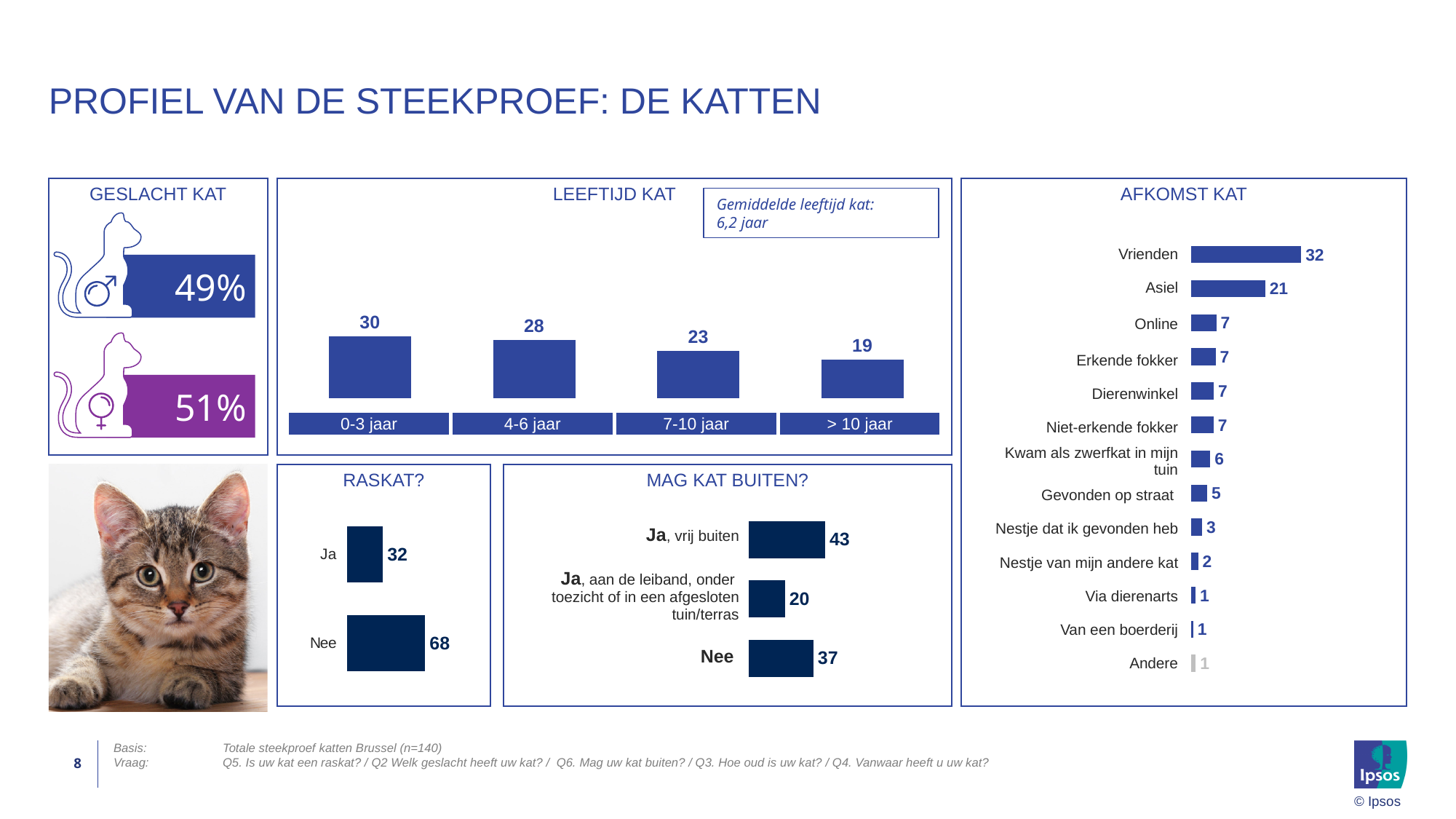
What type of chart is the AFKOMST KAT chart? bar chart In the AFKOMST KAT chart, what is the value for Asiel? 21 In the MAG KAT BUITEN? chart, what is the value for 'Ja, aan de leiband, onder toezicht of in een afgesloten tuin/terras'? 20 How many categories are shown in the AFKOMST KAT chart? 13 In the RASKAT? chart, what is the value for Nee? 68 In the LEEFTIJD KAT chart, what is the difference between the values for 4-6 jaar and 7-10 jaar? 5 In the LEEFTIJD KAT chart, what is the value for 0-3 jaar? 30 In the AFKOMST KAT chart, which category has the highest value? Vrienden In the AFKOMST KAT chart, what is the difference between Vrienden and Asiel? 11 In the LEEFTIJD KAT chart, which age category has the lowest value? > 10 jaar In the MAG KAT BUITEN? chart, which is larger: 'Ja, vrij buiten' or 'Nee'? Ja, vrij buiten In the LEEFTIJD KAT chart, do the values rise or fall from 0-3 jaar to > 10 jaar? fall